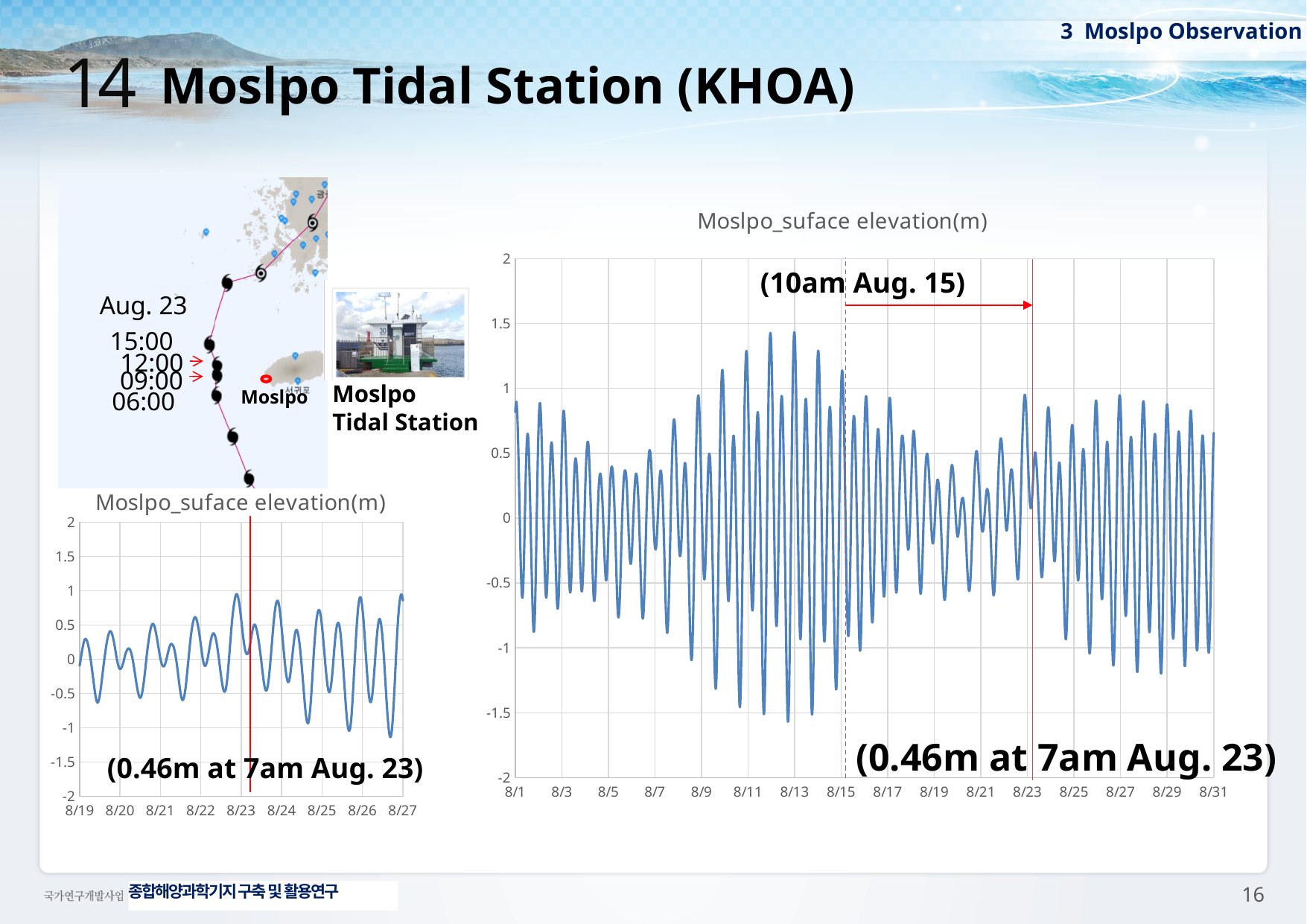
On the large chart on the right, is the lowest trough around 8/13 greater or less than -1? less On the large chart on the right, do the peak heights rise or fall from 8/9 to 8/13? rise On the small chart at the bottom left, is the trough just before 8/27 greater or less than -0.5? less On the large chart on the right, what date and time does the dashed vertical line mark? 10am Aug. 15 What is the title of the large chart on the right? Moslpo_suface elevation(m) On the large chart on the right, what surface elevation is annotated for 7am Aug. 23? 0.46m On the large chart on the right, which is higher: the peak around 8/13 or the peak around 8/23? the peak around 8/13 On the small chart at the bottom left, what value is annotated at 7am Aug. 23? 0.46m On the large chart on the right, is the highest peak around 8/13 greater or less than 1? greater How many date labels are shown on the x axis of the small chart at the bottom left? 9 How many date labels are shown on the x axis of the large chart on the right? 16 What kind of chart is the large chart on the right of the slide? line chart